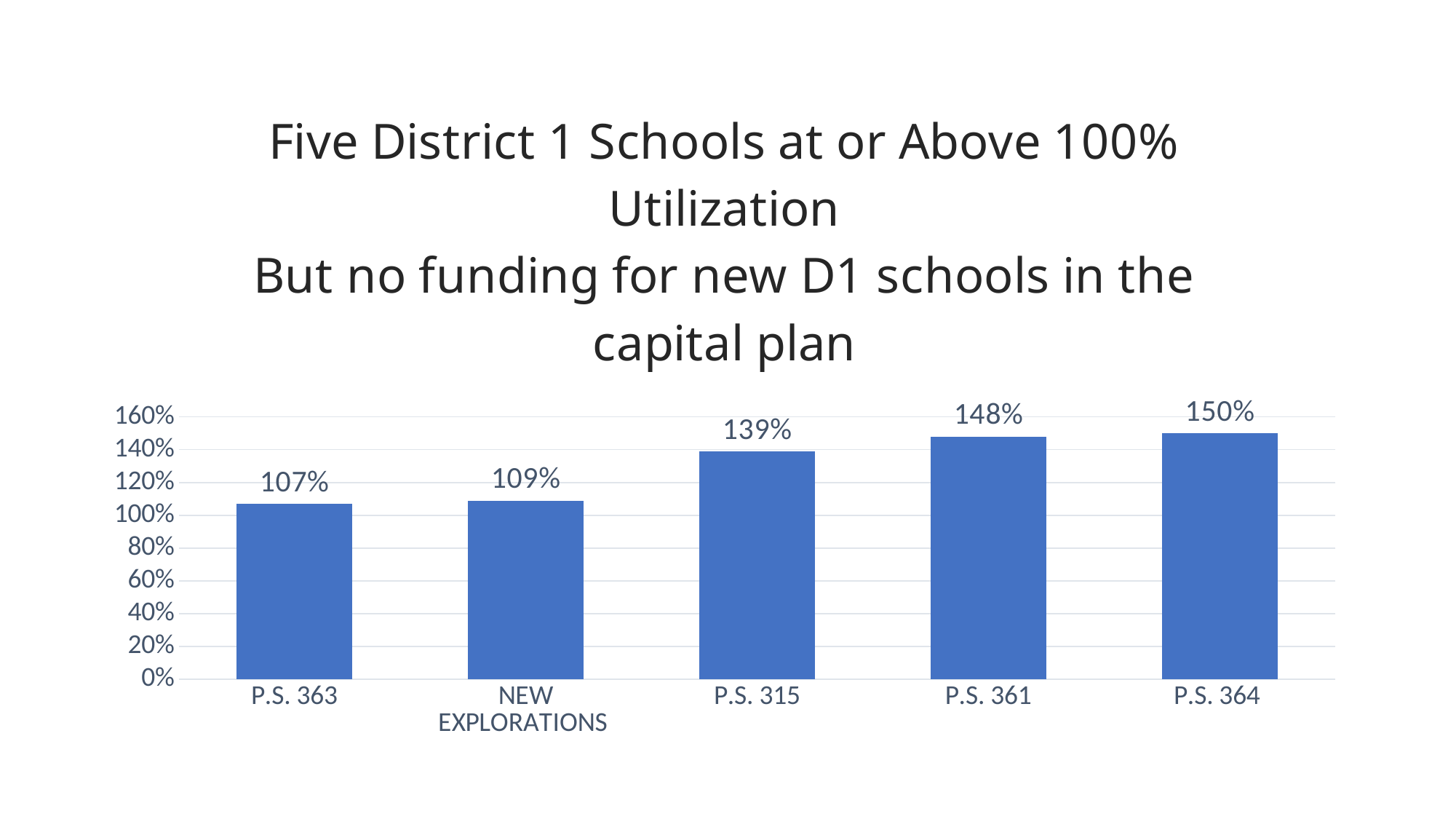
How many schools are shown in the chart? 5 What kind of chart is shown on the slide? Bar chart Do the values rise or fall from left to right across the chart? Rise Which school has the lowest utilization? P.S. 363 What is the highest value shown on the vertical axis? 160% Which has a higher utilization, P.S. 315 or New Explorations? P.S. 315 What is the utilization value for P.S. 315? 139% What is the difference between the utilization of P.S. 364 and P.S. 363? 43% What is the utilization value for P.S. 363? 107% Which school has the highest utilization? P.S. 364 What is the utilization value for P.S. 361? 148% What is the utilization value for New Explorations? 109%